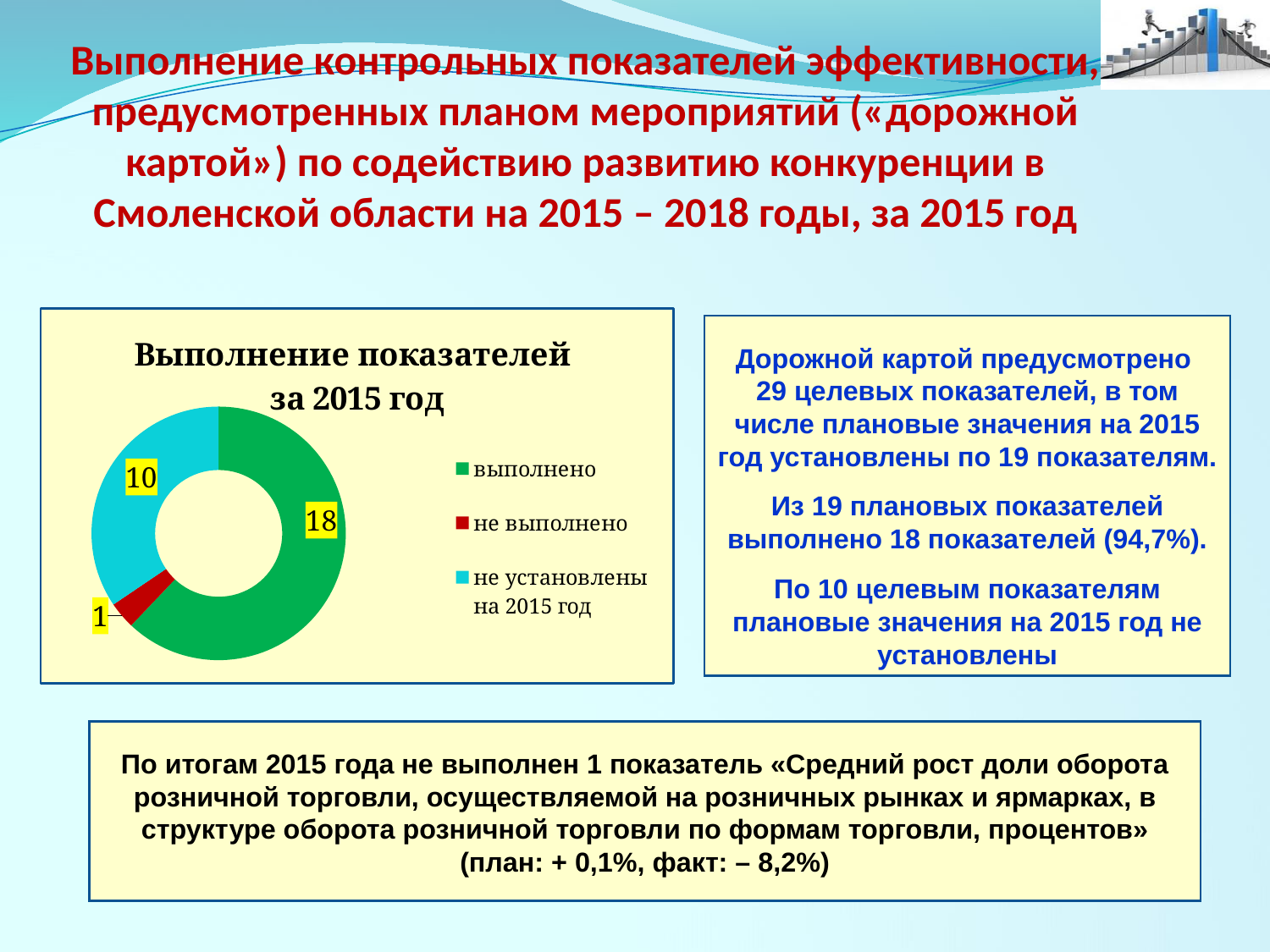
Which category has the smallest value in the chart? не выполнено What is the value for «не установлены на 2015 год» in the chart? 10 What kind of chart is shown on the slide? doughnut (pie) chart How many entries does the chart legend list? 3 Which category has the largest value in the chart? выполнено What is the total of all values shown in the chart? 29 How many categories does the chart show? 3 What is the value for «выполнено» in the chart «Выполнение показателей за 2015 год»? 18 What is the title of the chart? Выполнение показателей за 2015 год Which is larger: the value for «не установлены на 2015 год» or the value for «не выполнено»? не установлены на 2015 год What is the value for «не выполнено» in the chart? 1 What is the difference between the values for «выполнено» and «не установлены на 2015 год»? 8